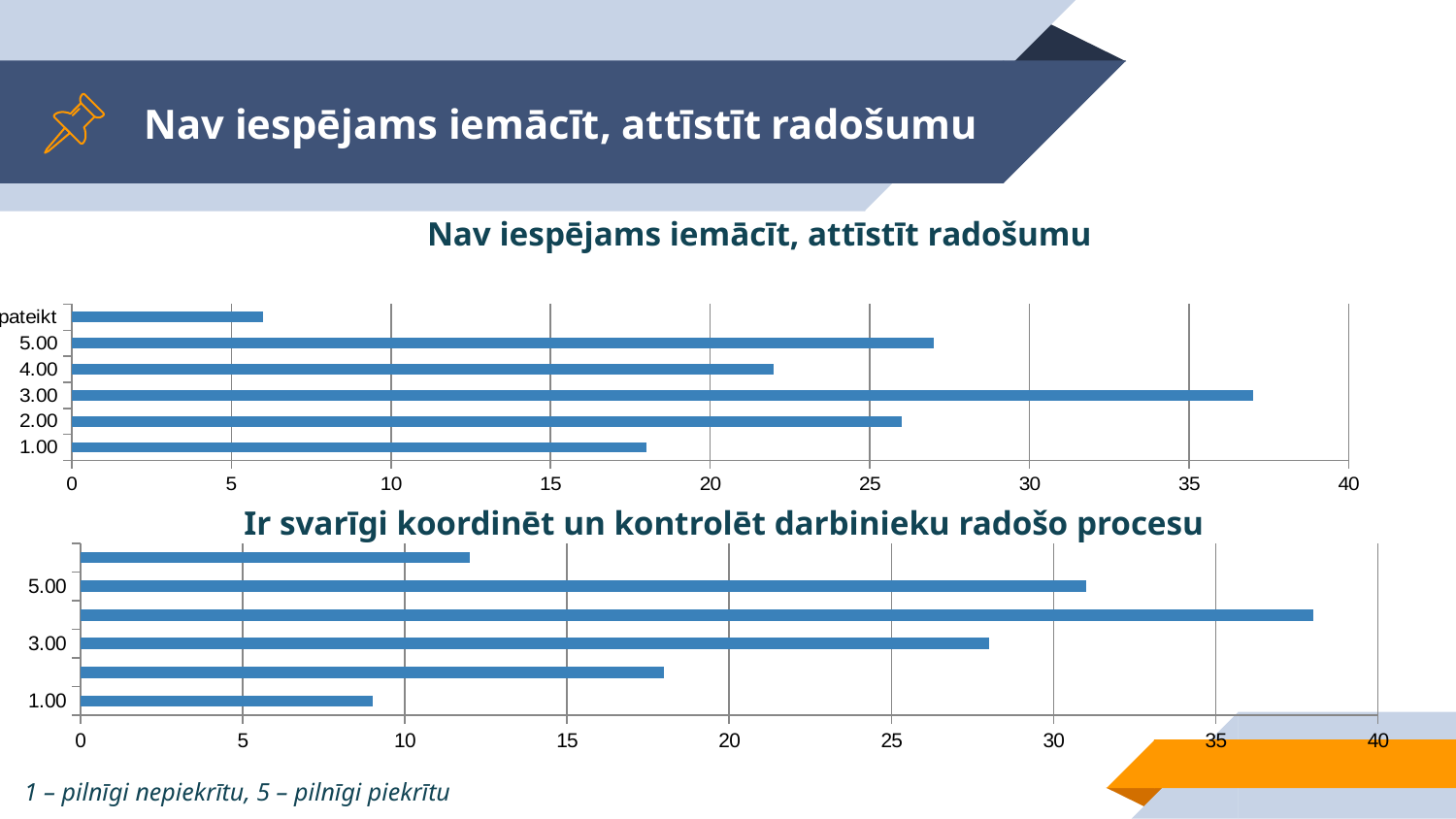
What kind of chart is the bottom chart titled "Ir svarīgi koordinēt un kontrolēt darbinieku radošo procesu"? bar chart In the top chart "Nav iespējams iemācīt, attīstīt radošumu", is the value for 3.00 greater or less than 35? greater How many bars are plotted in the top chart "Nav iespējams iemācīt, attīstīt radošumu"? 6 In the top chart "Nav iespējams iemācīt, attīstīt radošumu", is the value for 1.00 greater or less than 20? less In the bottom chart "Ir svarīgi koordinēt un kontrolēt darbinieku radošo procesu", which is larger, the value for 5.00 or the value for 1.00? 5.00 In the top chart "Nav iespējams iemācīt, attīstīt radošumu", which category has the longest bar? 3.00 What is the maximum value shown on the horizontal axis of the bottom chart "Ir svarīgi koordinēt un kontrolēt darbinieku radošo procesu"? 40 In the bottom chart "Ir svarīgi koordinēt un kontrolēt darbinieku radošo procesu", is the value for 3.00 greater or less than 30? less What kind of chart is the top chart titled "Nav iespējams iemācīt, attīstīt radošumu"? bar chart In the top chart "Nav iespējams iemācīt, attīstīt radošumu", which of the categories 1.00 to 5.00 has the shortest bar? 1.00 In the top chart "Nav iespējams iemācīt, attīstīt radošumu", which is larger, the value for 5.00 or the value for 4.00? 5.00